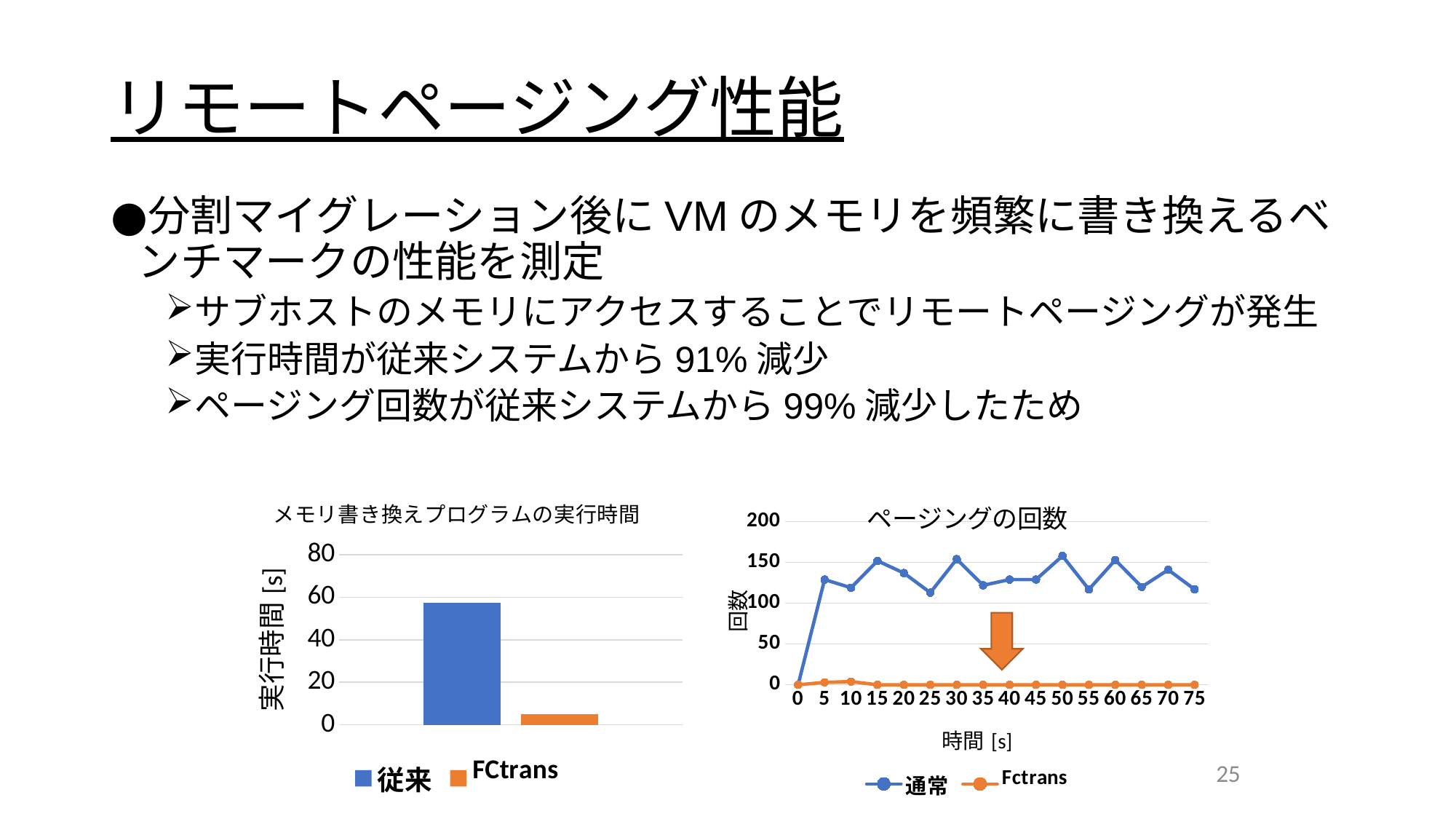
In the right chart (ページングの回数), how many time points are labelled on the x axis? 16 In the left chart (メモリ書き換えプログラムの実行時間), is the value for FCtrans greater or less than 20? less In the left chart (メモリ書き換えプログラムの実行時間), is the value for 従来 greater or less than 40? greater What kind of chart is the left chart titled メモリ書き換えプログラムの実行時間? bar chart In the left chart (メモリ書き換えプログラムの実行時間), how many series does the legend list? 2 In the right chart (ページングの回数), is the value for 通常 at 50 s greater or less than 100? greater In the right chart (ページングの回数), how many series does the legend list? 2 In the right chart (ページングの回数), which series has higher values over most of the time range, 通常 or Fctrans? 通常 What kind of chart is the right chart titled ページングの回数? line chart What is the y-axis label of the left chart (メモリ書き換えプログラムの実行時間)? 実行時間 [s] In the left chart (メモリ書き換えプログラムの実行時間), which series has the larger execution time, 従来 or FCtrans? 従来